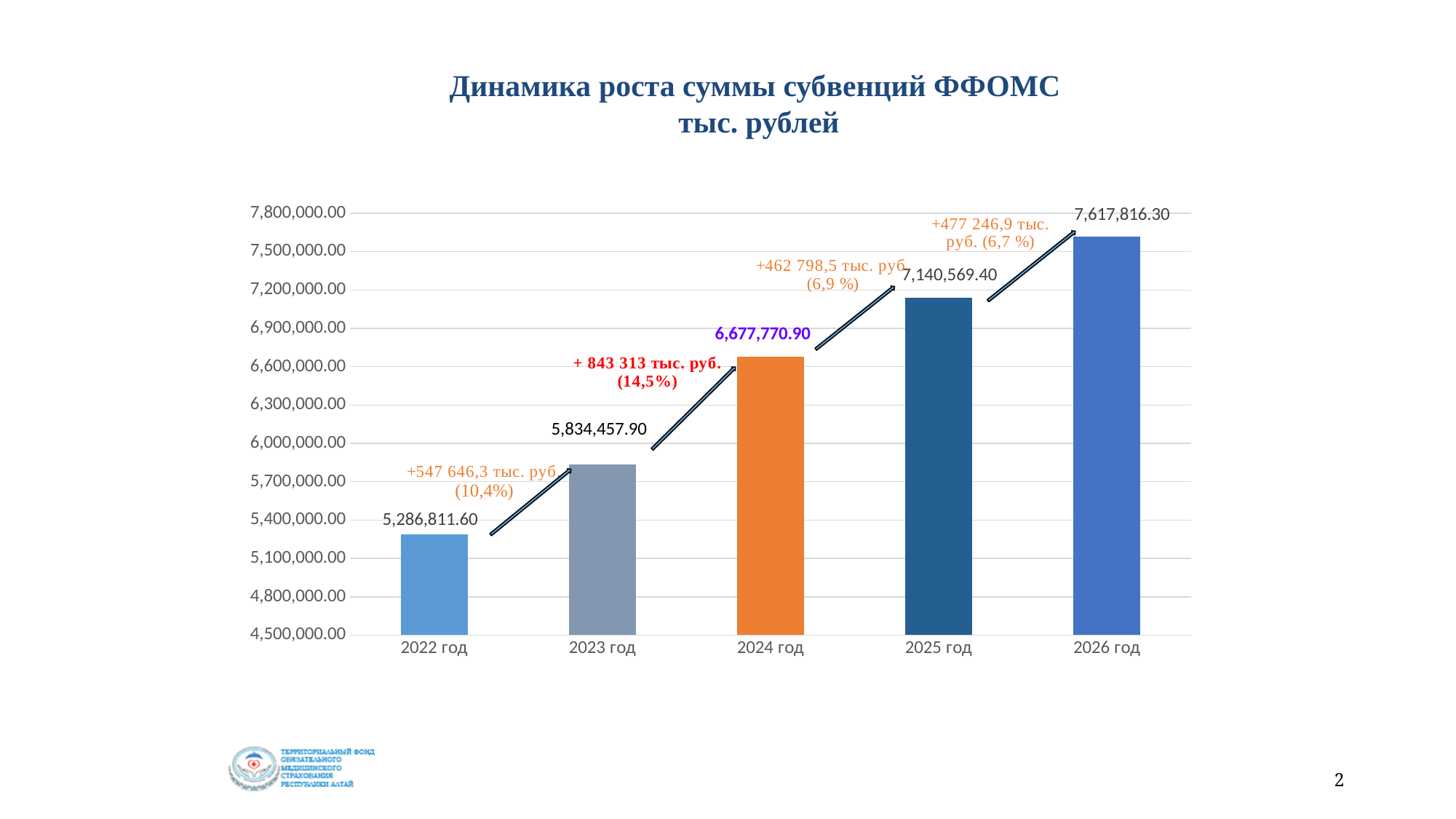
Which year has the lowest value? 2022 год What is the difference between the values for 2026 год and 2025 год? 477,246.90 Do the values rise or fall from 2022 год to 2026 год? rise What kind of chart is shown on the slide? bar chart What is the value for 2026 год? 7,617,816.30 Is the value for 2023 год greater or less than 6,000,000.00? less What is the value for 2022 год? 5,286,811.60 How many bars are shown in the chart? 5 What is the difference between the values for 2023 год and 2022 год? 547,646.30 What is the value for 2024 год? 6,677,770.90 Which year has the highest value? 2026 год Which is larger, the value for 2025 год or the value for 2024 год? 2025 год